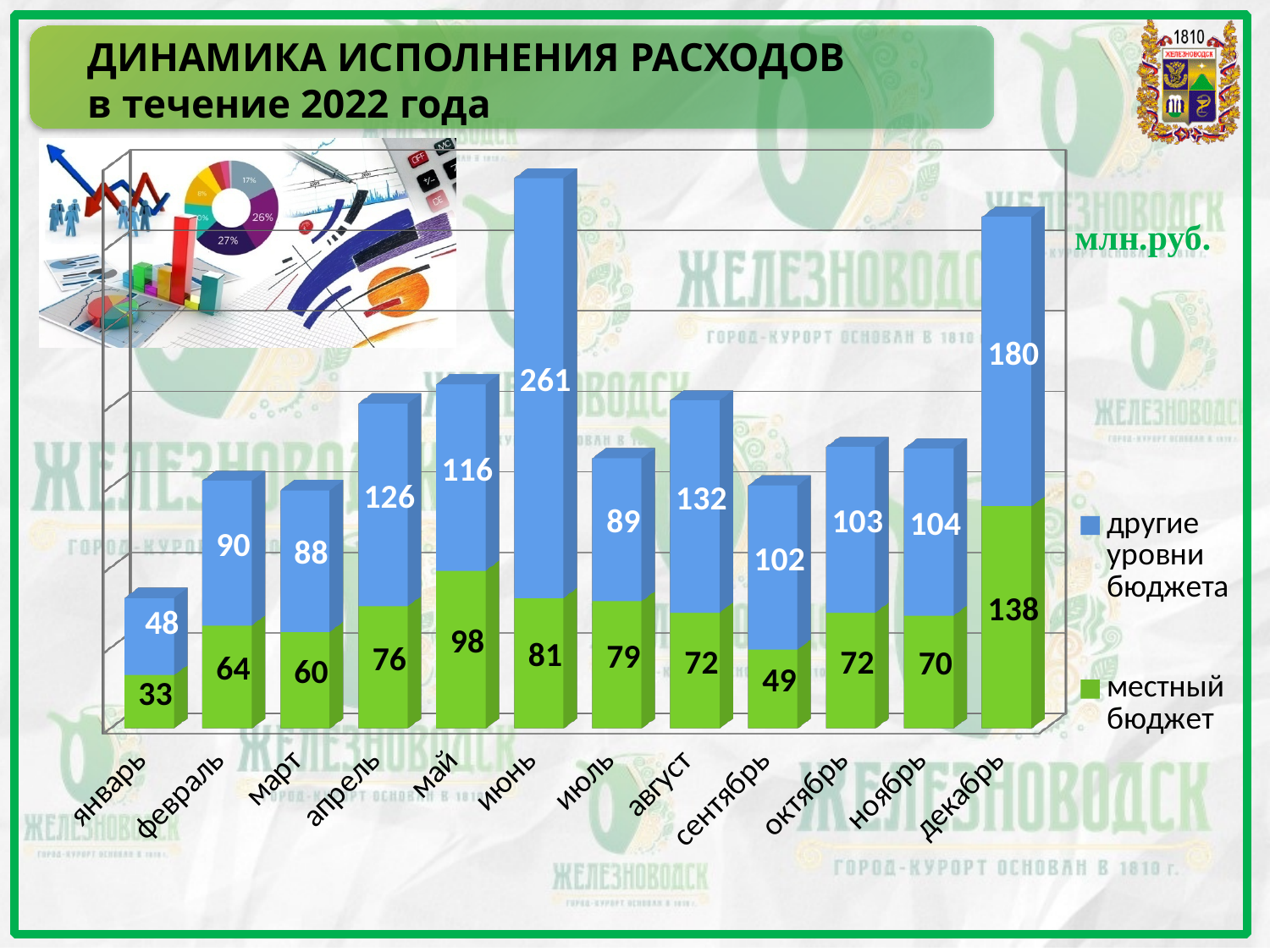
What kind of chart is shown on the slide? stacked bar chart How many months are shown on the x axis? 12 What unit of measurement is indicated on the chart? млн.руб. What is the value for "другие уровни бюджета" in июнь? 261 How many series does the legend list? 2 What is the value for "местный бюджет" in январь? 33 Which month has the highest value for "другие уровни бюджета"? июнь What is the total of the stacked bar for сентябрь? 151 Which month has the lowest value for "местный бюджет"? январь Which is larger: the "местный бюджет" value for май or for июнь? май What is the difference between the "другие уровни бюджета" values for декабрь and ноябрь? 76 What is the value for "местный бюджет" in декабрь? 138